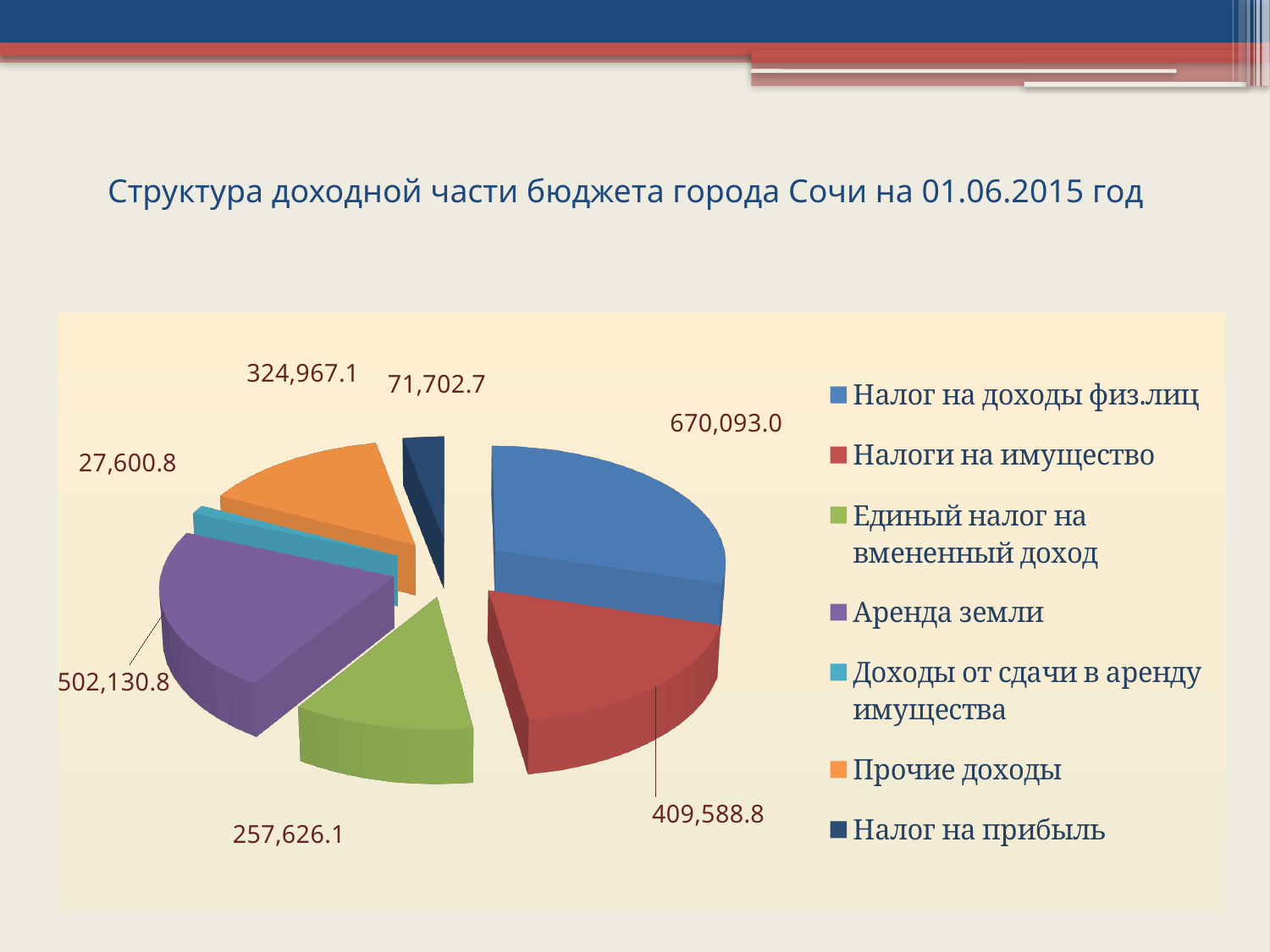
What is the title of the slide? Структура доходной части бюджета города Сочи на 01.06.2015 год What type of chart is shown on the slide? Pie chart Which is larger: Аренда земли or Единый налог на вмененный доход? Аренда земли Which category has the smallest value? Доходы от сдачи в аренду имущества How many entries does the legend list? 7 What is the value for Налог на доходы физ.лиц? 670,093.0 What is the value for Аренда земли? 502,130.8 How many slices does the pie chart have? 7 What is the difference between Налог на доходы физ.лиц and Налоги на имущество? 260,504.2 Which category has the largest value? Налог на доходы физ.лиц What is the value for Прочие доходы? 324,967.1 What is the value for Доходы от сдачи в аренду имущества? 27,600.8